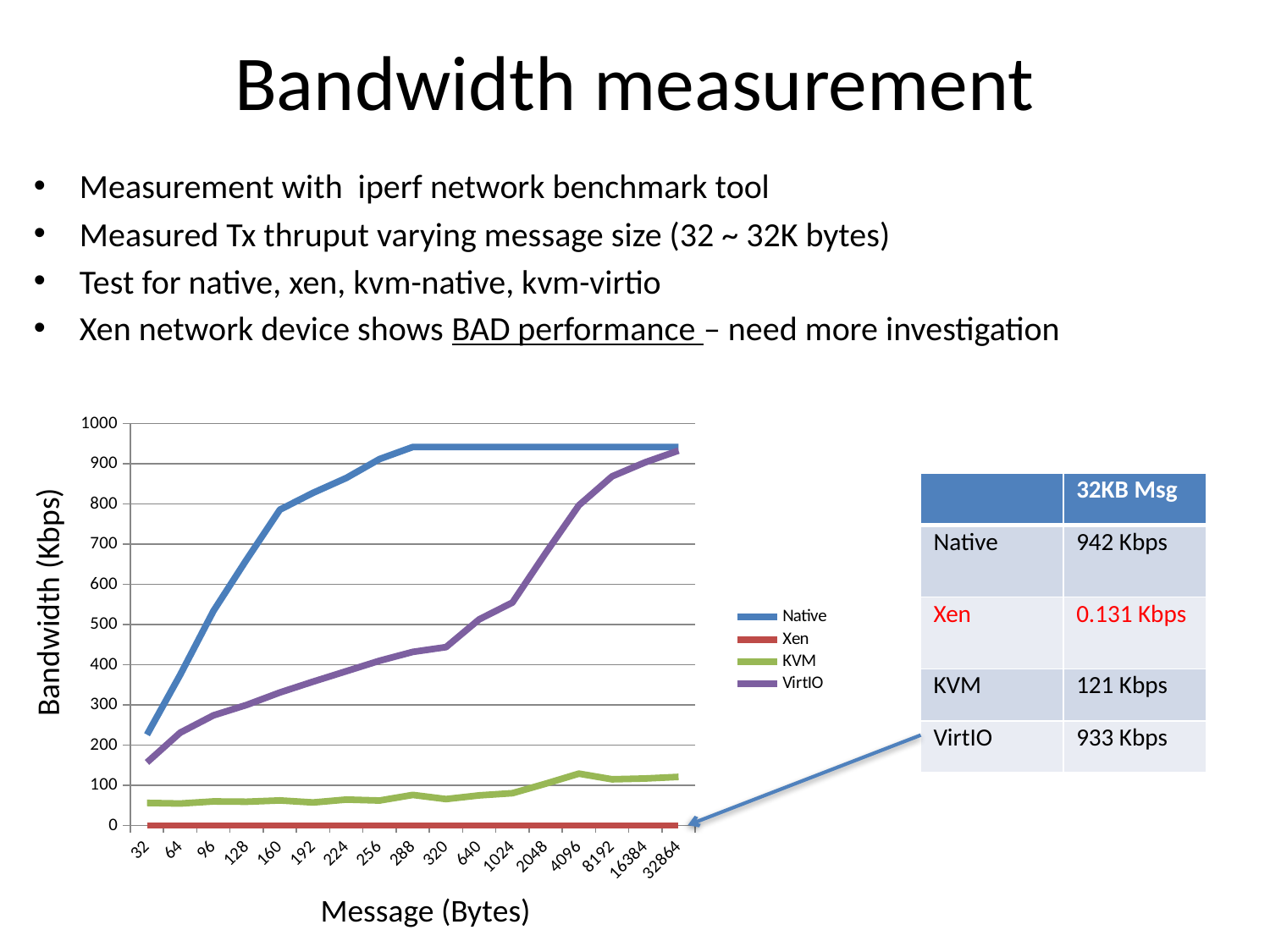
How many message sizes are plotted along the x axis of the chart? 17 Which series has the lowest bandwidth at the 32KB message size? Xen According to the table, what is the bandwidth for VirtIO at the 32KB message size? 933 Kbps According to the table, what is the bandwidth for Xen at the 32KB message size? 0.131 Kbps Is the Native bandwidth at a message size of 160 bytes greater or less than 700? greater What is the label of the y axis of the chart? Bandwidth (Kbps) What kind of chart is shown on the slide? line chart According to the table, what is the bandwidth for Native at the 32KB message size? 942 Kbps Is the VirtIO bandwidth at a message size of 320 bytes greater or less than 500? less How many series does the chart legend list? 4 What is the difference between the Native and KVM bandwidths at the 32KB message size? 821 Kbps Which series has the highest bandwidth at the 32KB message size? Native